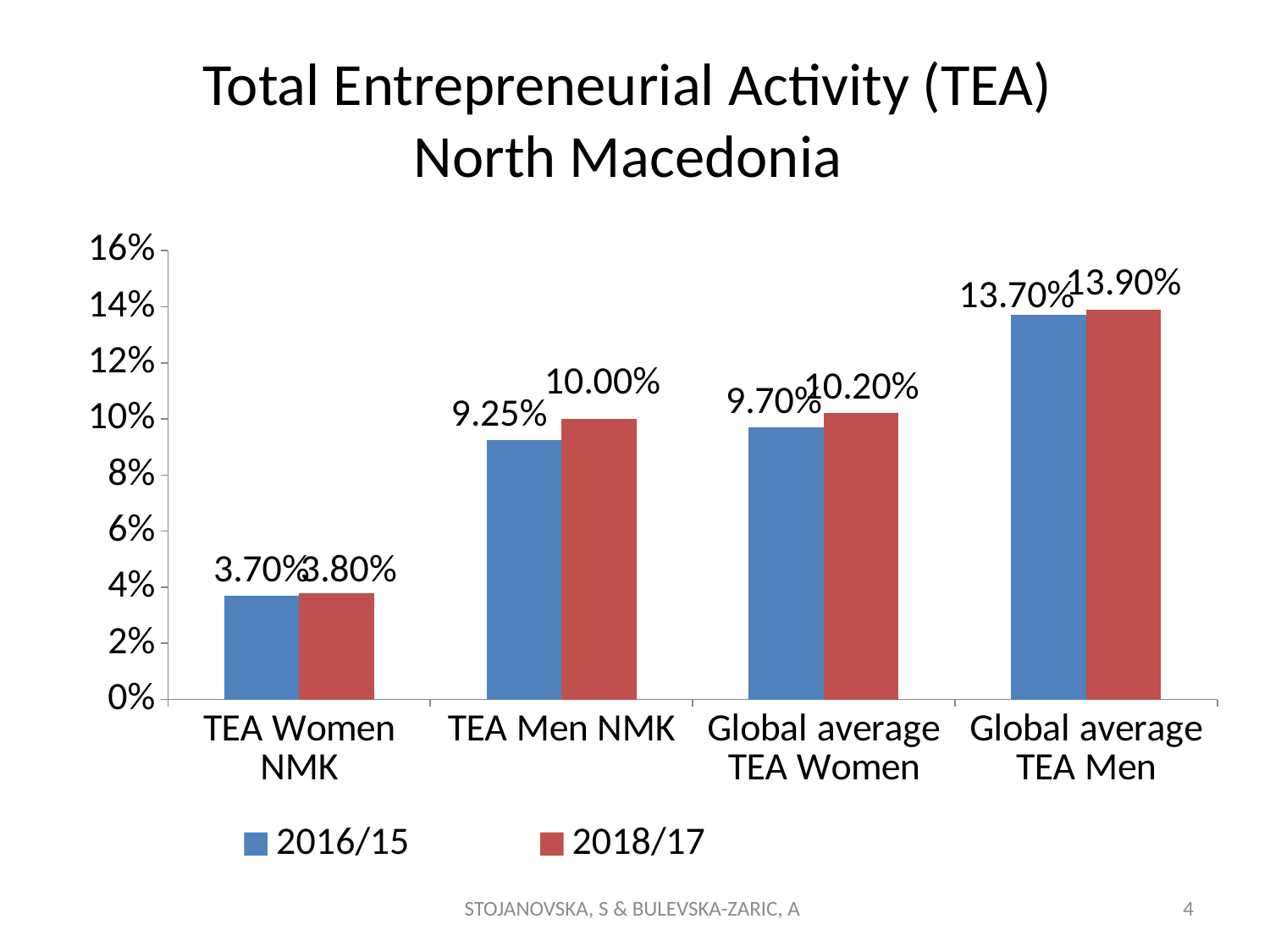
What is the difference between the 2018/17 and 2016/15 values for TEA Men NMK? 0.75% How many categories are shown on the x axis? 4 Which category has the highest 2018/17 value? Global average TEA Men What is the 2016/15 value for TEA Women NMK? 3.70% Which category has the lowest 2016/15 value? TEA Women NMK What is the 2018/17 value for Global average TEA Men? 13.90% How many series does the legend list? 2 What is the 2016/15 value for Global average TEA Women? 9.70% What is the 2018/17 value for TEA Men NMK? 10.00% Is the 2016/15 value for Global average TEA Men greater or less than 12%? greater What kind of chart is shown on the slide? bar chart Which is larger: the 2016/15 value for TEA Men NMK or the 2016/15 value for Global average TEA Women? Global average TEA Women